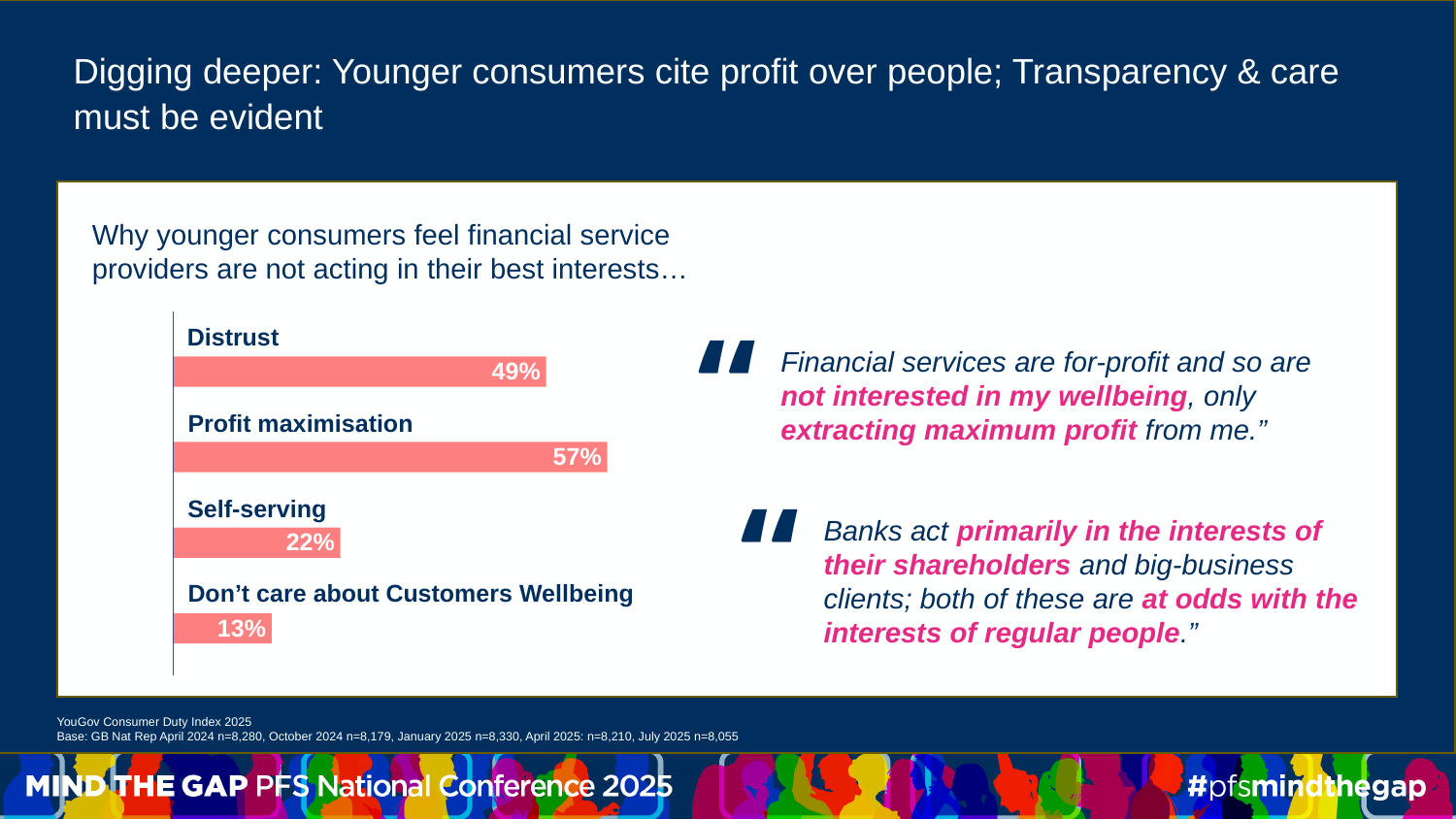
What is the value shown for Self-serving? 22% Which reason has the lowest percentage in the chart? Don't care about Customers Wellbeing How many reasons (categories) are shown in the chart? 4 What percentage of younger consumers cite Distrust as a reason financial service providers are not acting in their best interests? 49% What is the difference between the values for Self-serving and Don't care about Customers Wellbeing? 9% Which is larger, the value for Distrust or the value for Self-serving? Distrust Which reason has the highest percentage in the chart? Profit maximisation What is the difference between the values for Profit maximisation and Distrust? 8% What is the value shown for Don't care about Customers Wellbeing? 13% What colour are the bars in the chart? Pink (salmon) What is the value shown for Profit maximisation? 57% What kind of chart is used to show why younger consumers feel providers are not acting in their best interests? Bar chart